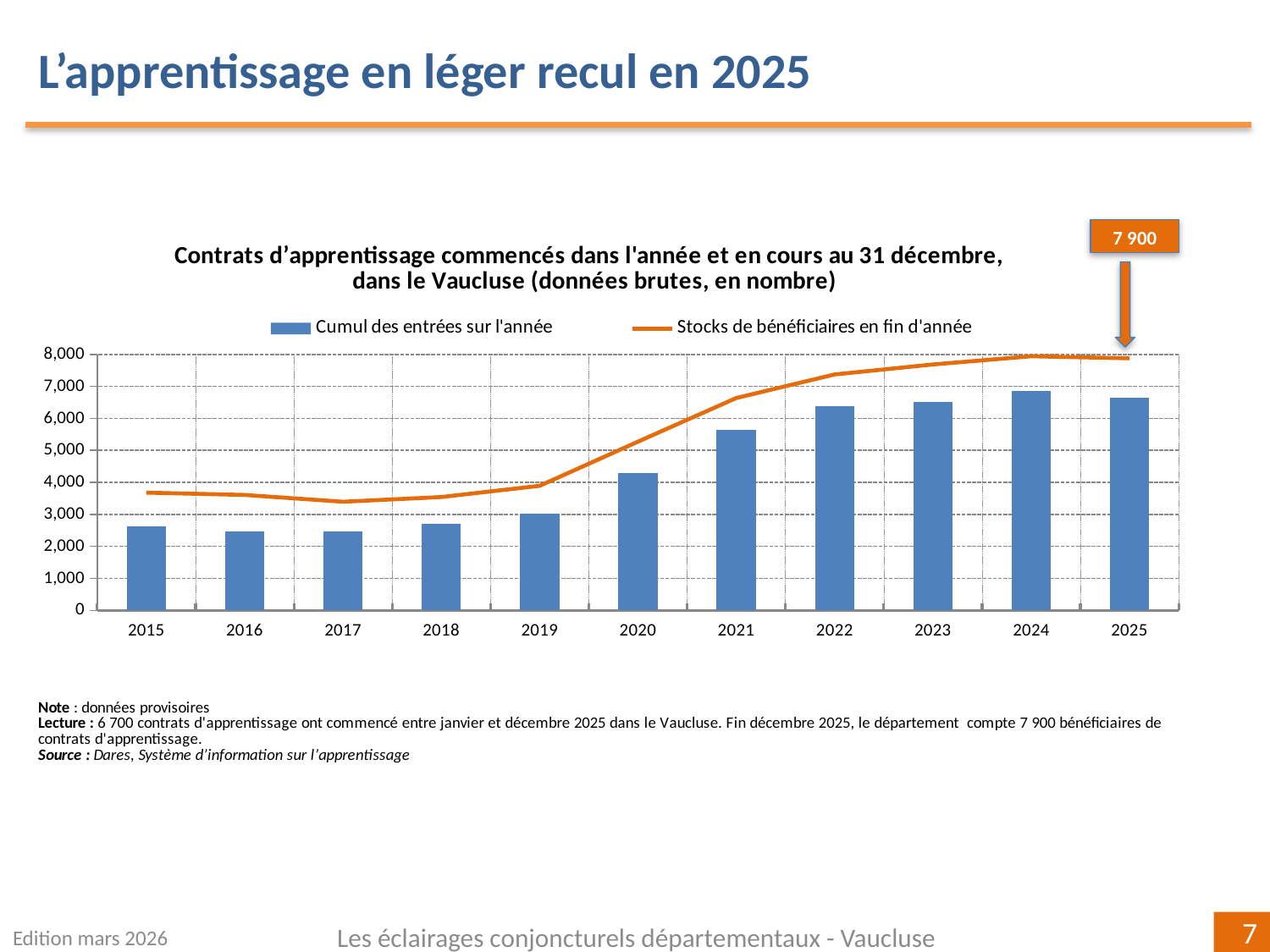
In which year is the line 'Stocks de bénéficiaires en fin d'année' at its lowest? 2017 Do the bars for 'Cumul des entrées sur l'année' rise or fall from 2019 to 2024? rise Is the value of 'Stocks de bénéficiaires en fin d'année' in 2020 greater or less than 5,000? greater What kind of chart is shown on the slide? A combined bar and line chart Which year has the larger bar for 'Cumul des entrées sur l'année', 2024 or 2025? 2024 How many years are shown on the x axis of the chart? 11 What colour is the line for 'Stocks de bénéficiaires en fin d'année'? Orange What is the value of 'Stocks de bénéficiaires en fin d'année' for 2025? 7 900 Is the bar value for 'Cumul des entrées sur l'année' in 2021 greater or less than 5,000? greater How many series does the chart legend list? 2 Is the bar value for 'Cumul des entrées sur l'année' in 2015 greater or less than 3,000? less In which year is the bar for 'Cumul des entrées sur l'année' the highest? 2024